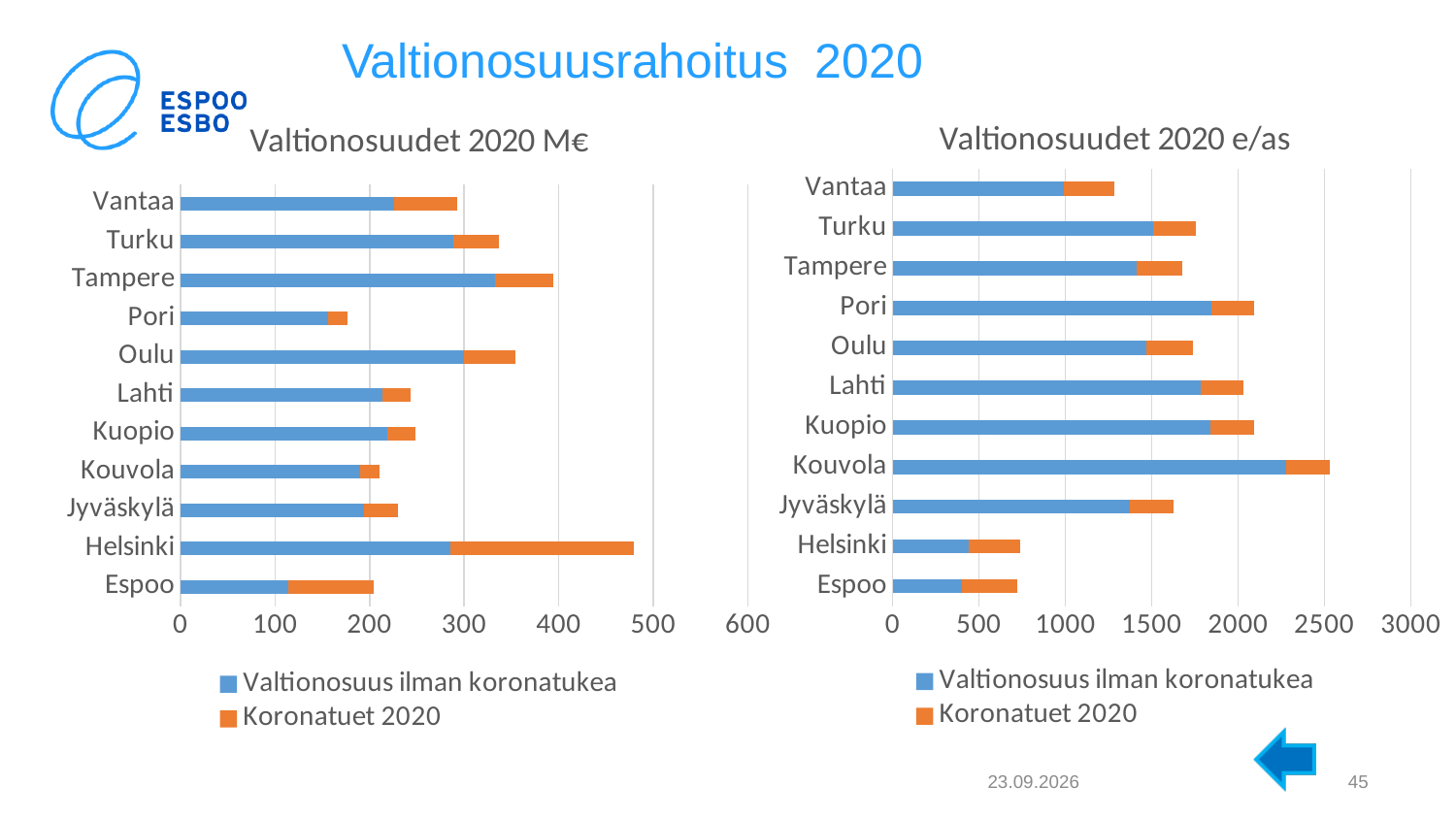
In the 'Valtionosuudet 2020 M€' chart, which city has the highest total value? Helsinki In the 'Valtionosuudet 2020 M€' chart, is the total value for Helsinki greater or less than 400? greater In the 'Valtionosuudet 2020 M€' chart, which city has the lowest total value? Pori In the 'Valtionosuudet 2020 e/as' chart, is the total value for Vantaa greater or less than 1500? less What type of chart is the 'Valtionosuudet 2020 M€' chart on the left? Stacked bar chart In the 'Valtionosuudet 2020 M€' chart, which city has a larger total value, Tampere or Oulu? Tampere In the 'Valtionosuudet 2020 e/as' chart, which city has the highest total value? Kouvola Which series is shown in orange in the 'Valtionosuudet 2020 M€' chart? Koronatuet 2020 How many series does the legend of the 'Valtionosuudet 2020 e/as' chart list? 2 In the 'Valtionosuudet 2020 e/as' chart, is the total value for Kouvola greater or less than 2000? greater How many cities are shown in the 'Valtionosuudet 2020 M€' chart? 11